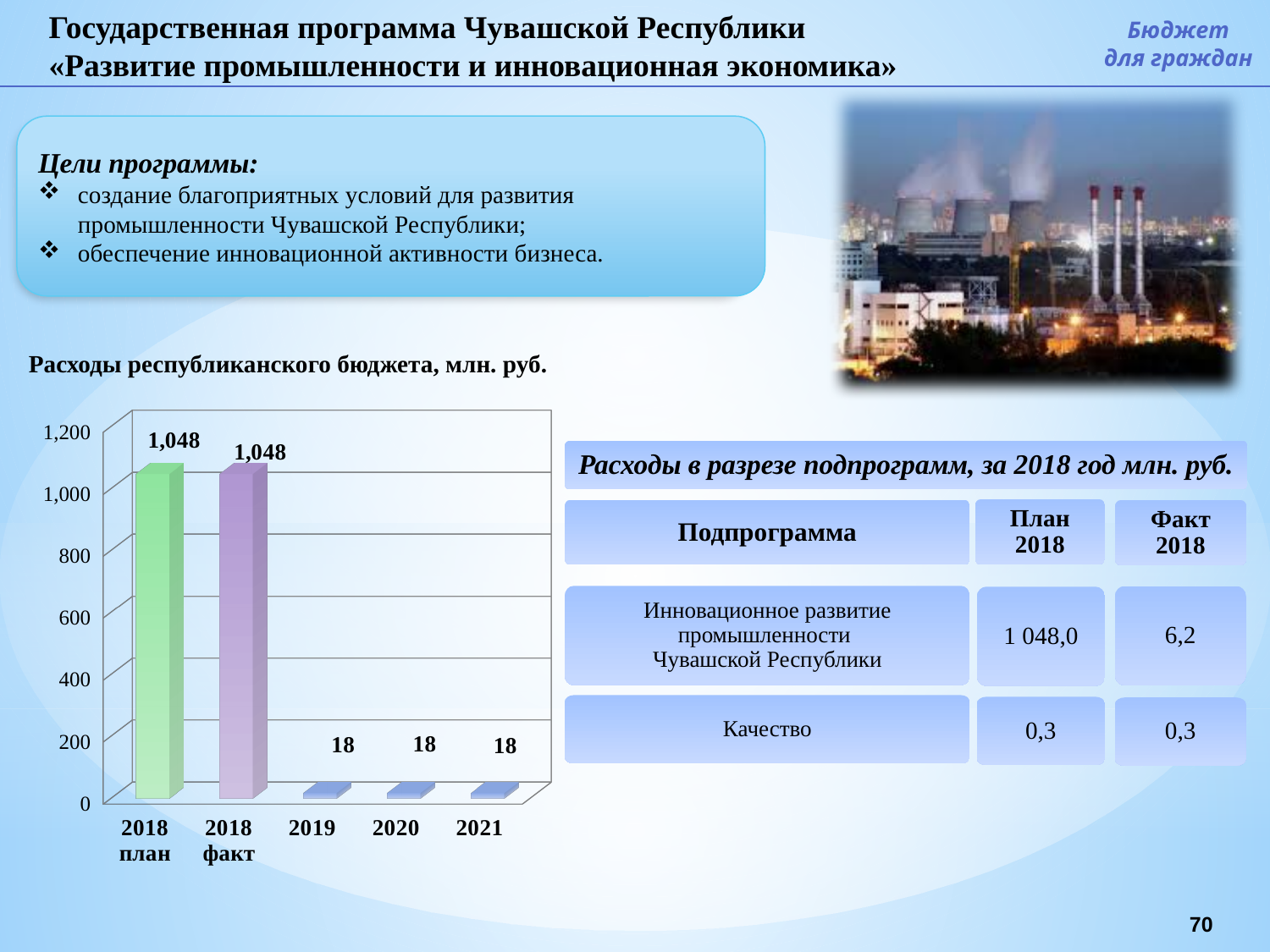
What is the value for 2018 факт in the chart? 1,048 Is the value for 2018 факт greater or less than 1,000? greater What is the title of the chart on the slide? Расходы республиканского бюджета, млн. руб. What is the value for 2019 in the chart? 18 Is the value for 2020 greater or less than 200? less Which is larger, the value for 2018 план or the value for 2019? 2018 план What is the value for 2018 план in the chart 'Расходы республиканского бюджета, млн. руб.'? 1,048 How many categories are shown on the x axis of the chart? 5 What kind of chart is shown on the slide? bar chart Do the values rise or fall from 2018 факт to 2021? fall What is the value for 2021 in the chart? 18 What is the difference between the value for 2018 факт and the value for 2020? 1,030